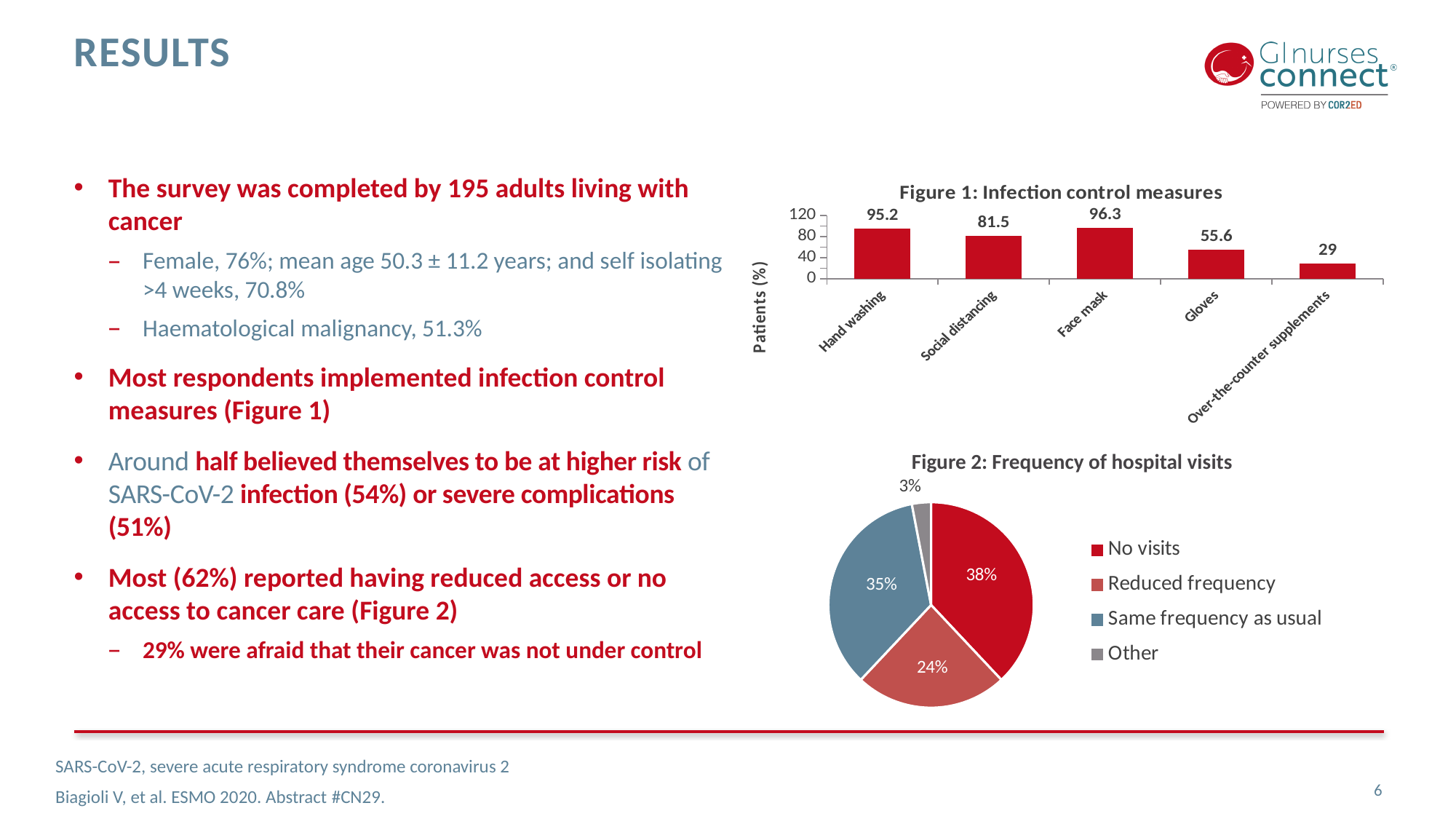
In Figure 1: Infection control measures, how many categories are shown? 5 In Figure 1: Infection control measures, what is the value for Social distancing? 81.5 In Figure 1: Infection control measures, which category has the highest value? Face mask What kind of chart is Figure 1: Infection control measures? Bar chart In Figure 1: Infection control measures, what is the value for Over-the-counter supplements? 29 In Figure 2: Frequency of hospital visits, which slice is the largest? No visits In Figure 1: Infection control measures, which category has the lowest value? Over-the-counter supplements In Figure 2: Frequency of hospital visits, how many entries does the legend list? 4 In Figure 1: Infection control measures, what is the difference between Hand washing and Gloves? 39.6 In Figure 1: Infection control measures, which is larger, Social distancing or Gloves? Social distancing In Figure 1: Infection control measures, what is the y-axis label? Patients (%) In Figure 2: Frequency of hospital visits, what share of the pie is Same frequency as usual? 35%